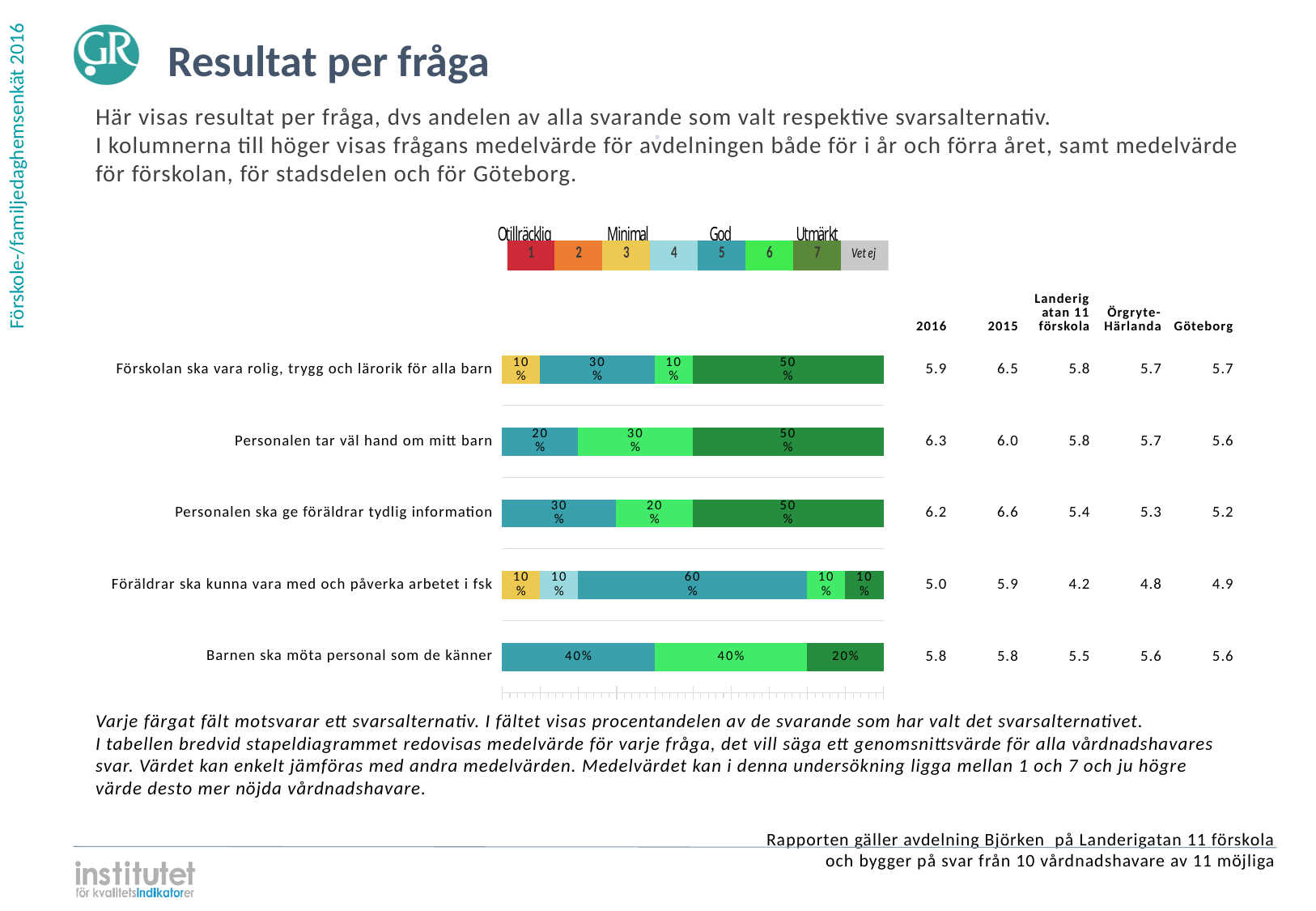
What percentage of respondents chose answer option 6 for 'Barnen ska möta personal som de känner'? 40% Which question has the smallest share of respondents choosing answer option 7 (Utmärkt)? Föräldrar ska kunna vara med och påverka arbetet i fsk What is the 2016 mean value for 'Personalen tar väl hand om mitt barn'? 6.3 How many questions (categories) are shown in the bar chart? 5 What percentage of respondents chose answer option 7 (Utmärkt) for 'Personalen tar väl hand om mitt barn'? 50% How many answer options, including 'Vet ej', does the colour legend above the chart show? 8 Which question has the largest share of respondents choosing answer option 5 (God)? Föräldrar ska kunna vara med och påverka arbetet i fsk What kind of chart is used to show the results per question? stacked bar chart For 'Förskolan ska vara rolig, trygg och lärorik för alla barn', is the share choosing option 5 larger or smaller than the share choosing option 3? larger What percentage of respondents chose answer option 5 for 'Föräldrar ska kunna vara med och påverka arbetet i fsk'? 60% What is the Göteborg mean value for 'Föräldrar ska kunna vara med och påverka arbetet i fsk'? 4.9 For 'Personalen ska ge föräldrar tydlig information', what is the difference between the share choosing option 7 and the share choosing option 6? 30%